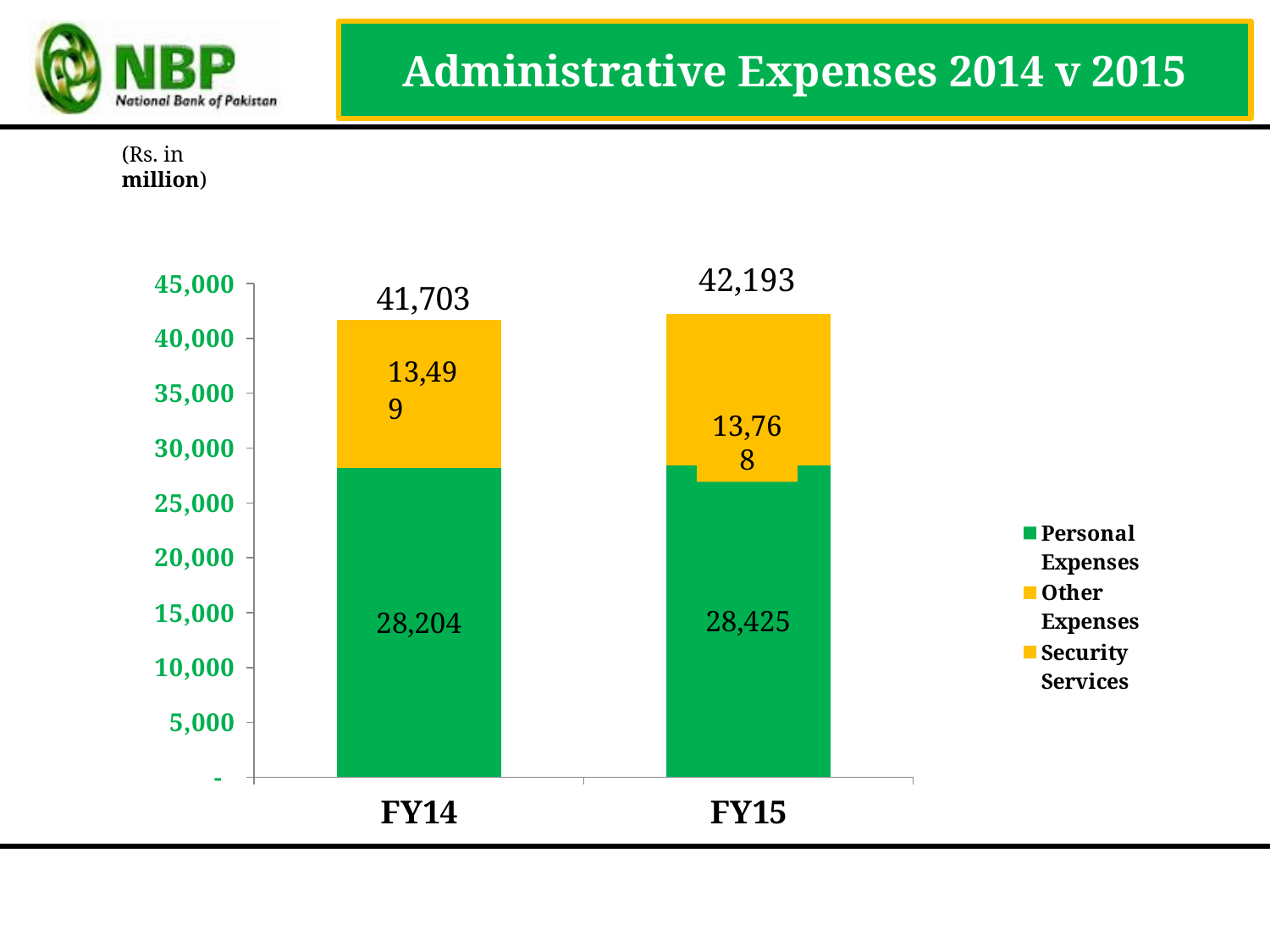
What is the total administrative expense shown for FY14? 41,703 What is the total administrative expense shown for FY15? 42,193 What kind of chart is shown on the slide? Stacked bar chart What is the value of Personal Expenses for FY14? 28,204 In what unit are the values on the chart expressed? Rs. in million What is the value of Personal Expenses for FY15? 28,425 Which year has the higher Other Expenses, FY14 or FY15? FY15 How many series does the legend list? 3 By how much did Personal Expenses increase from FY14 to FY15? 221 What is the value of Other Expenses for FY15? 13,768 What is the value of Other Expenses for FY14? 13,499 What is the difference between the FY15 total and the FY14 total? 490